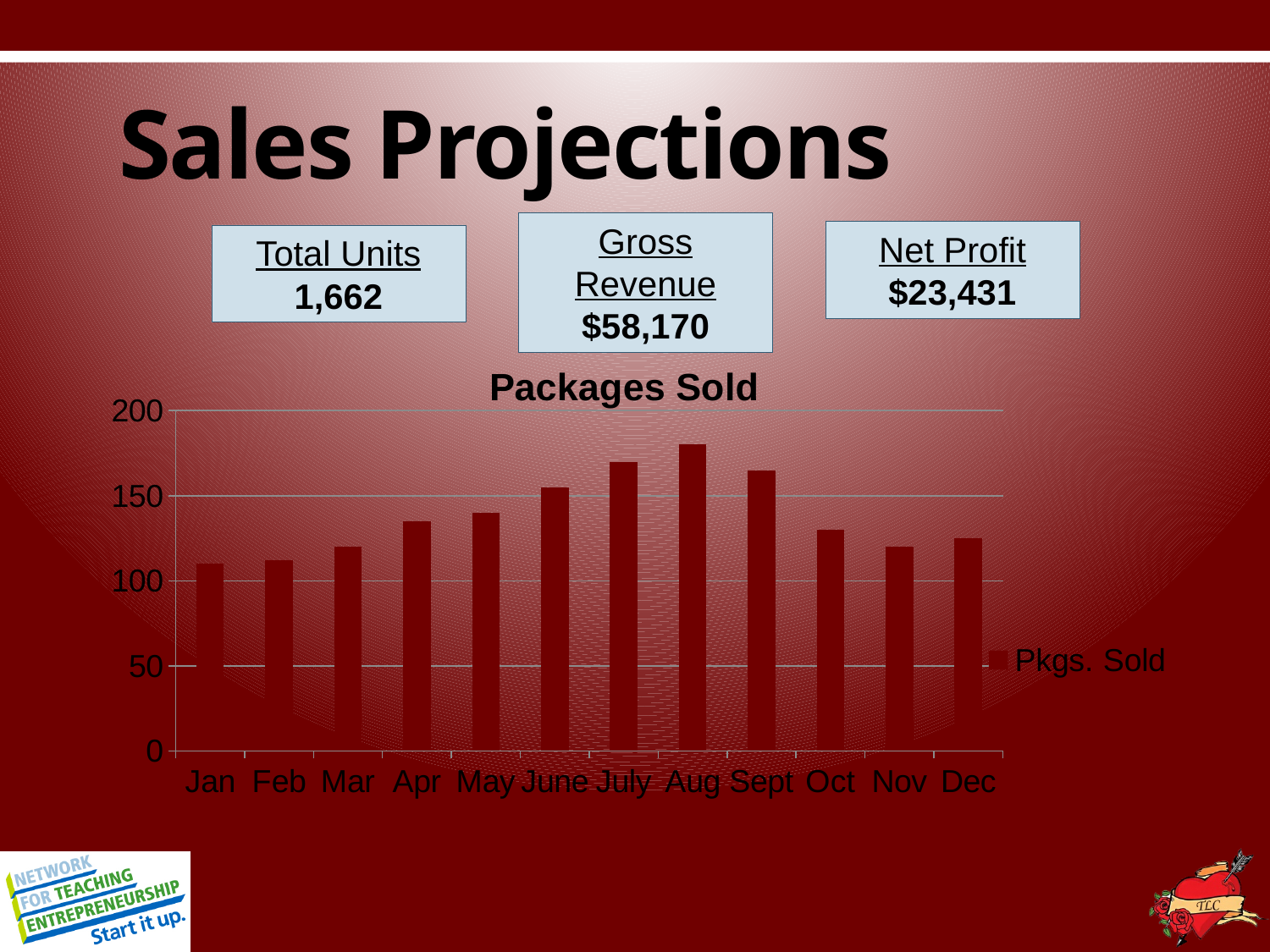
Do the values rise or fall from Jan to Aug? rise What is the name of the series in the chart's legend? Pkgs. Sold Is the value for July greater or less than 150? greater Is the value for Oct greater or less than 150? less What kind of chart is shown on the slide? bar chart What is the title of the chart? Packages Sold Is the value for Jan greater or less than 100? greater How many series does the chart's legend list? 1 How many months are shown on the x axis of the chart? 12 Which month has the highest number of packages sold? Aug Which month has more packages sold, July or Oct? July